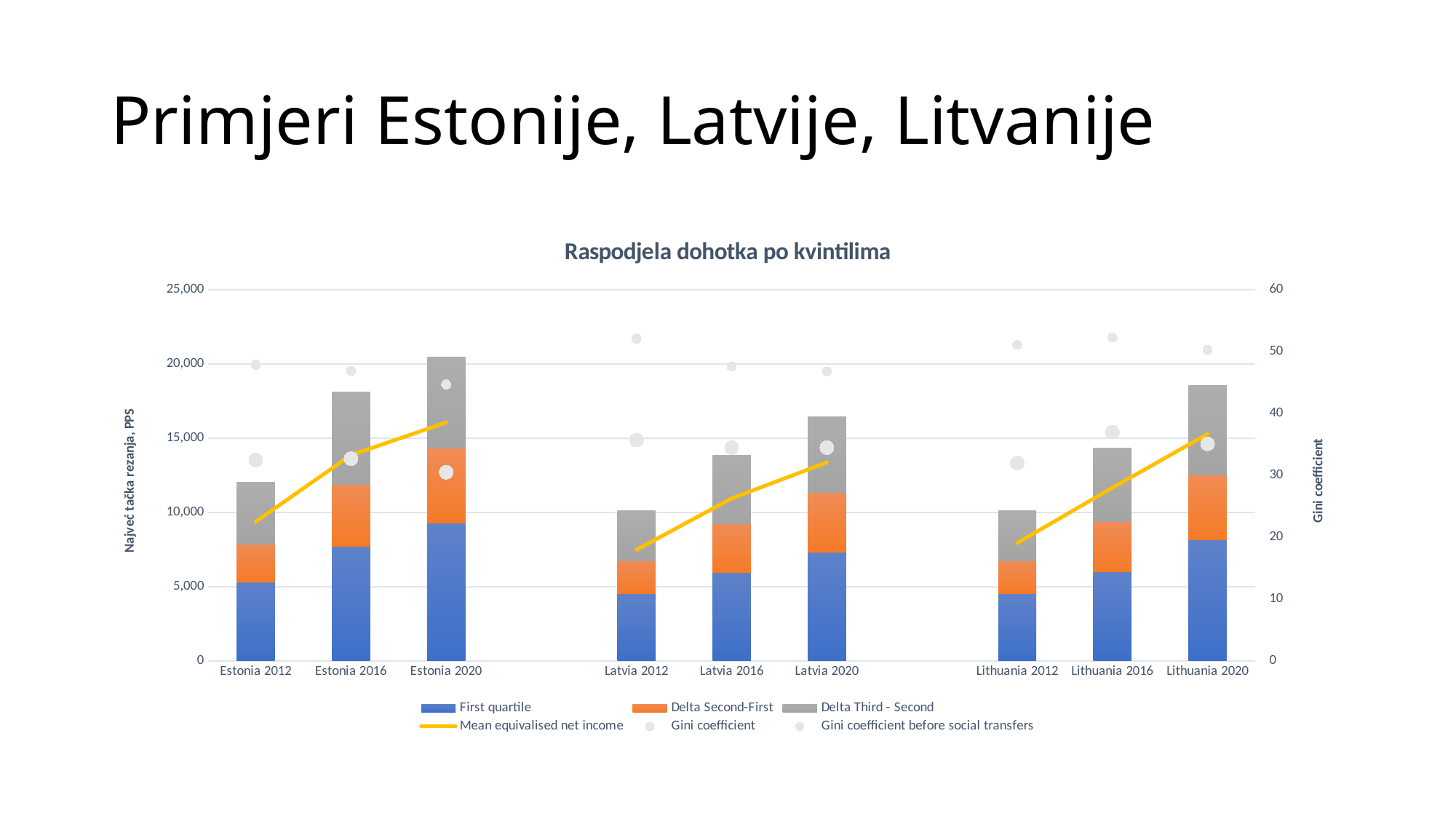
Is the total stacked bar for Latvia 2016 greater or less than 15,000? less Is the total stacked bar for Estonia 2020 greater or less than 20,000? greater What is the title of the chart? Raspodjela dohotka po kvintilima Is the First quartile value for Estonia 2020 greater or less than 5,000? greater What kind of chart is shown on the slide? stacked bar chart with a line and scatter markers How many series does the chart legend list? 6 Which has the taller stacked bar, Estonia 2016 or Latvia 2016? Estonia 2016 Which has the taller stacked bar, Lithuania 2020 or Latvia 2020? Lithuania 2020 How many categories are shown on the x axis? 9 Which category has the tallest stacked bar? Estonia 2020 Does the Mean equivalised net income line rise or fall from 2012 to 2020 for each country? rise What is the label of the right-hand vertical axis? Gini coefficient